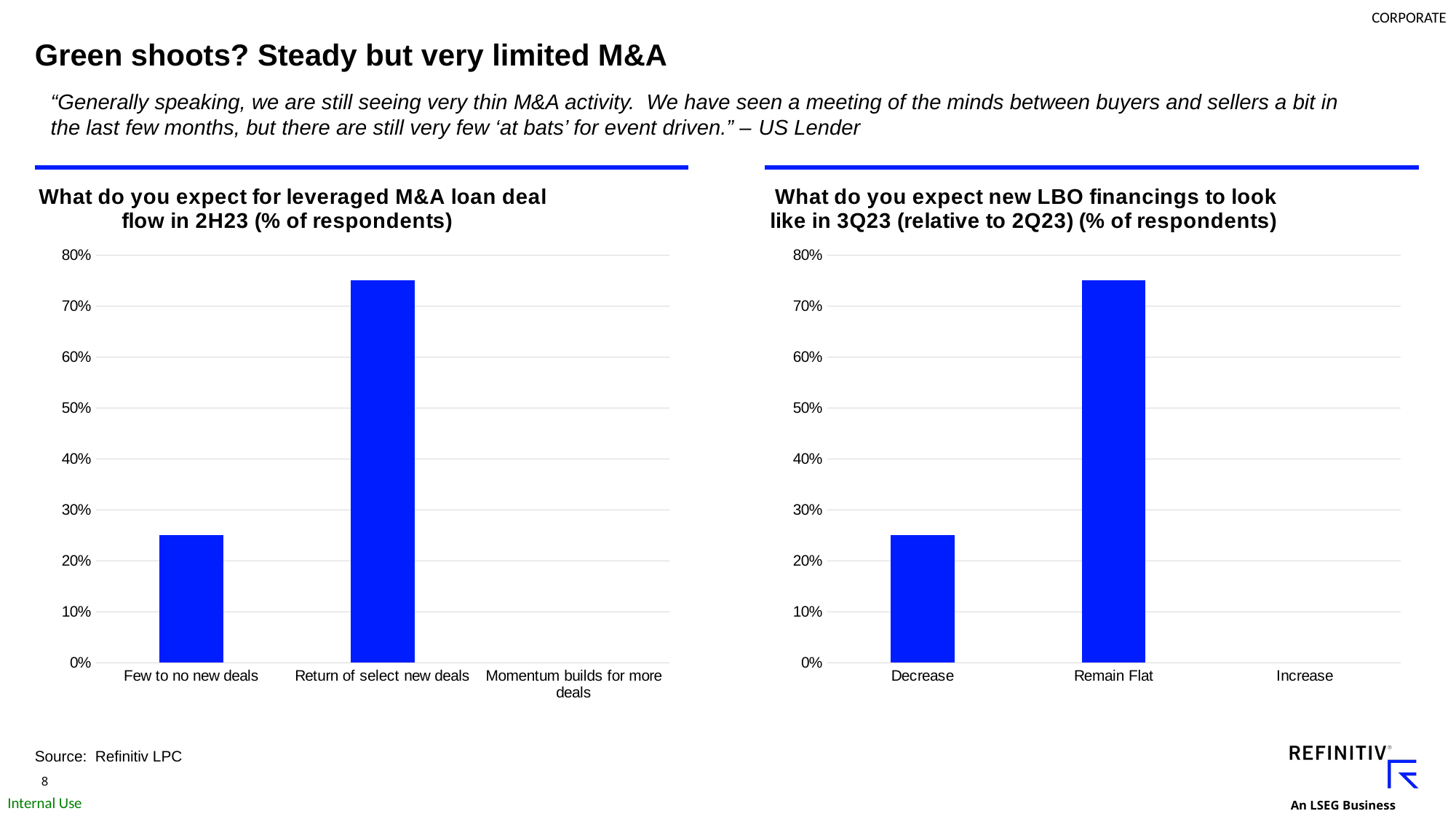
What is the source cited for the charts on the slide? Refinitiv LPC In the right chart (new LBO financings in 3Q23), which category has the highest share of respondents? Remain Flat In the left chart (leveraged M&A loan deal flow in 2H23), is the value for 'Few to no new deals' greater or less than 30%? less In the left chart (leveraged M&A loan deal flow in 2H23), how many categories are shown on the x axis? 3 In the right chart (new LBO financings in 3Q23), is the value for 'Decrease' greater or less than 20%? greater In the right chart (new LBO financings in 3Q23), which is larger: the value for 'Decrease' or the value for 'Remain Flat'? Remain Flat In the right chart (new LBO financings in 3Q23), which category has the lowest share of respondents? Increase In the left chart (leveraged M&A loan deal flow in 2H23), which category has the lowest share of respondents? Momentum builds for more deals In the right chart (new LBO financings in 3Q23), is the value for 'Remain Flat' greater or less than 80%? less In the left chart (leveraged M&A loan deal flow in 2H23), which category has the highest share of respondents? Return of select new deals What kind of chart is the right chart (new LBO financings in 3Q23)? Bar chart